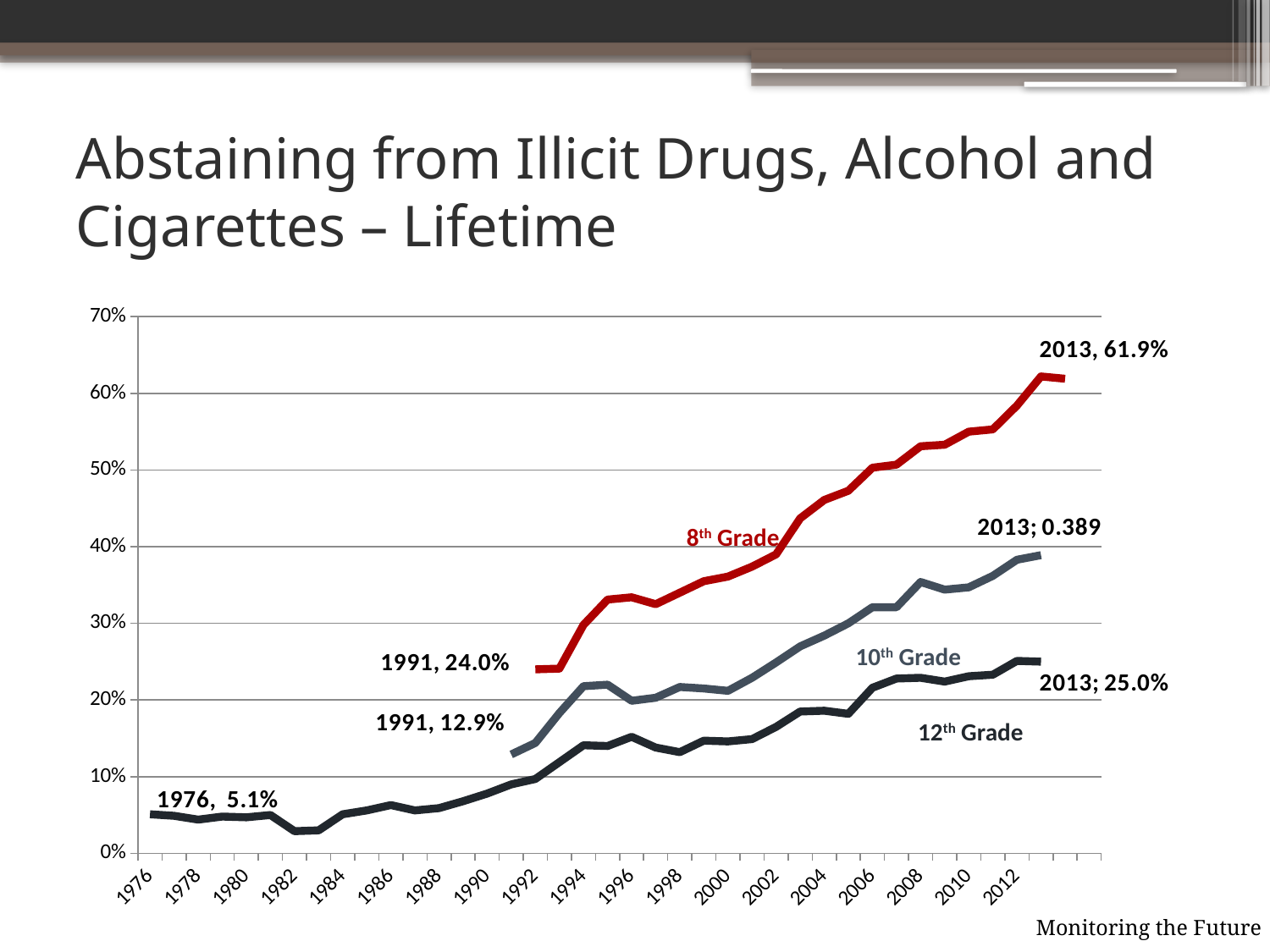
What is the labelled value for 8th Grade in 2013? 61.9% How many series (grade levels) are plotted on the chart? 3 What is the labelled value for 10th Grade in 2013? 0.389 Does the 8th Grade line generally rise or fall from 1991 to 2013? rise What is the labelled value for 8th Grade in 1991? 24.0% What is the labelled value for 10th Grade in 1991? 12.9% What is the labelled value for 12th Grade in 2013? 25.0% What is the labelled value for 12th Grade in 1976? 5.1% What kind of chart is shown on the slide? line chart Which grade level has the highest value in 2013? 8th Grade Which grade level has the lowest value in 2013? 12th Grade Is the 12th Grade value in 2006 greater or less than 30%? less